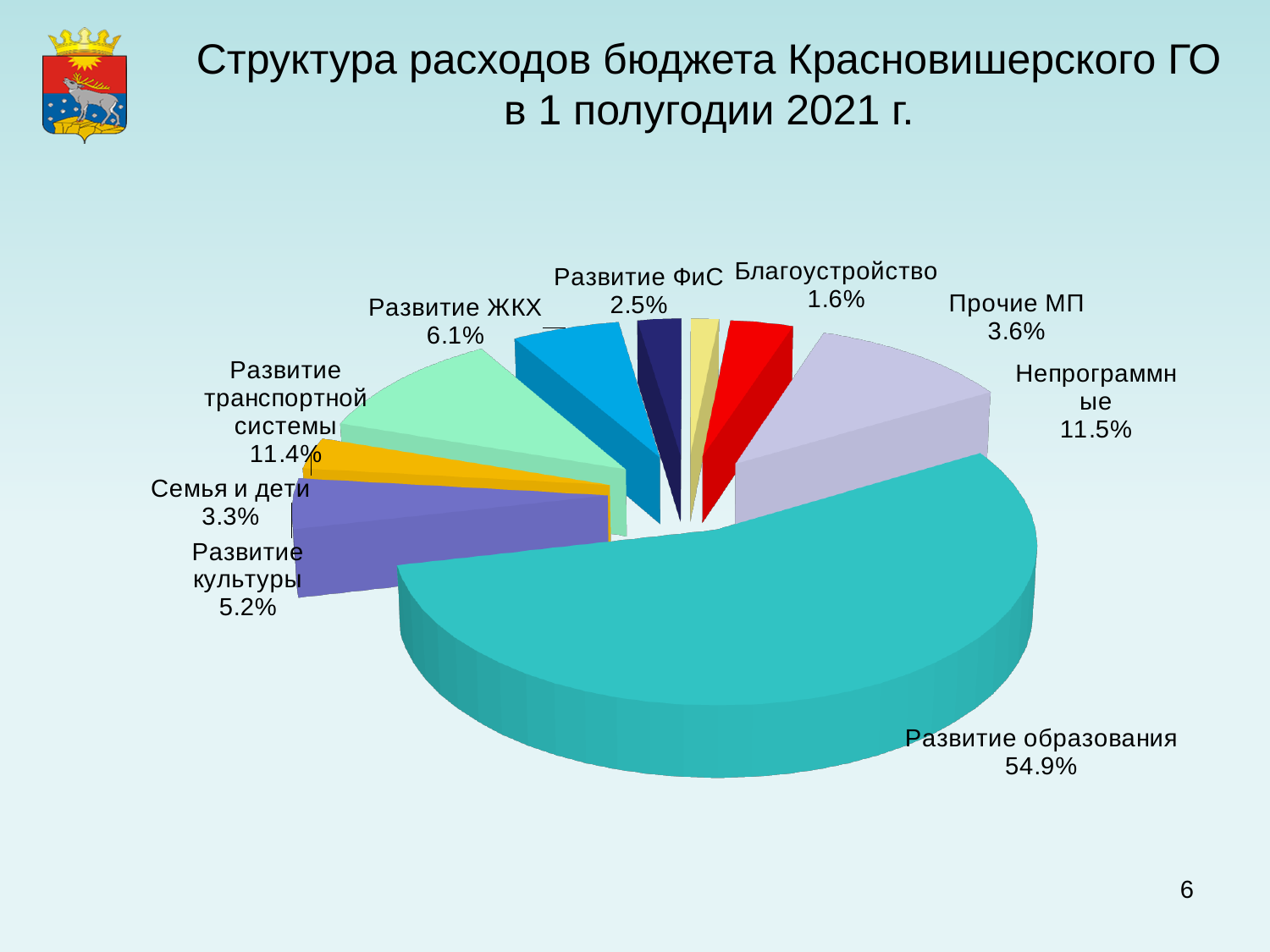
What is the difference between the shares of Развитие образования and Непрограммные? 43.4% What is the value shown for Развитие транспортной системы? 11.4% Which category has the largest slice of the pie? Развитие образования Which category has the smallest slice of the pie? Благоустройство What type of chart is shown on the slide? Pie chart What is the title of the slide? Структура расходов бюджета Красновишерского ГО в 1 полугодии 2021 г. Which is larger, the share for Развитие культуры or the share for Семья и дети? Развитие культуры How many categories are shown in the pie chart? 9 What share of the budget expenditure goes to Развитие образования? 54.9% What is the value shown for Непрограммные? 11.5% What is the value shown for Благоустройство? 1.6% What is the value shown for Развитие ЖКХ? 6.1%